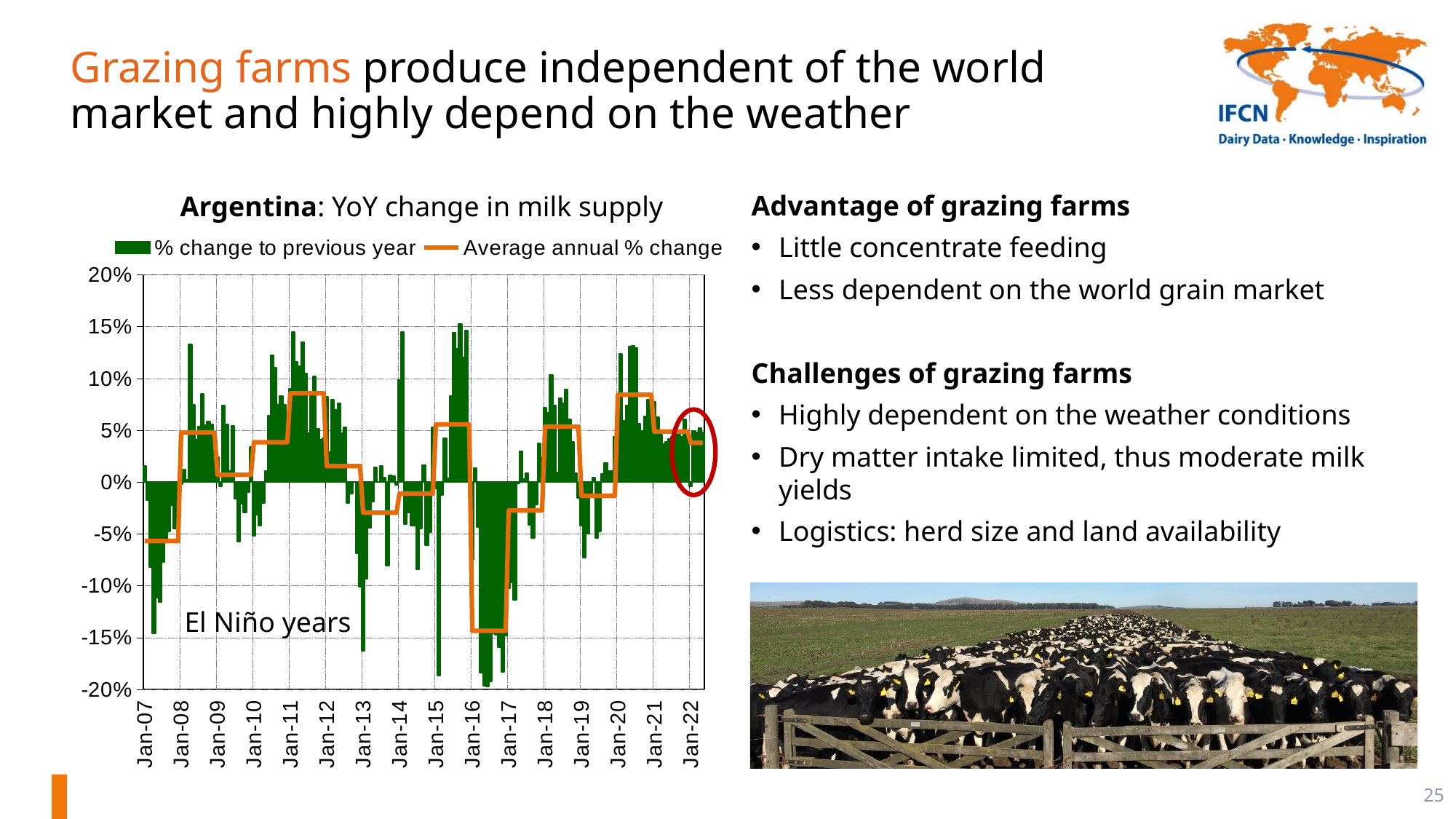
What is the title of the chart on the slide? Argentina: YoY change in milk supply How many series does the legend of the Argentina chart list? 2 In which year (by its Jan label) does the average annual % change reach its lowest level in the Argentina chart? Jan-16 Is the average annual % change for the year starting Jan-20 greater or less than 5%? greater Is the lowest monthly '% change to previous year' bar in the Argentina chart greater or less than -15%? less Is the average annual % change for the year starting Jan-07 greater or less than 0%? less Which series in the Argentina chart is drawn as an orange line? Average annual % change How many year labels are shown on the x axis of the Argentina chart? 16 What kind of chart is used to show the '% change to previous year' series in the Argentina milk supply chart? bar chart